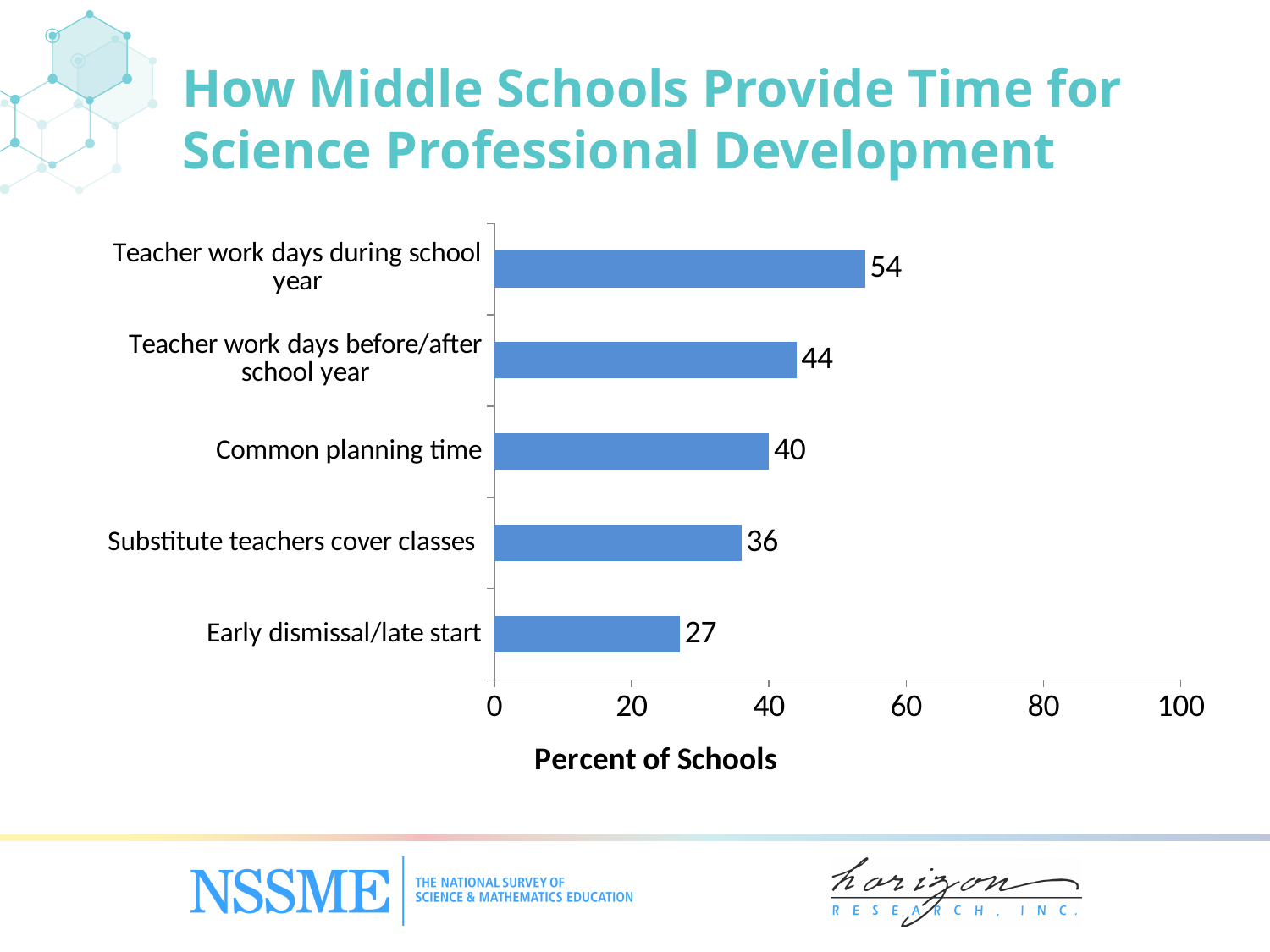
What kind of chart is shown on the slide? Bar chart What is the value for Early dismissal/late start? 27 What is the label of the horizontal axis? Percent of Schools Which is larger: the value for Common planning time or the value for Substitute teachers cover classes? Common planning time What is the difference between the values for Teacher work days during school year and Teacher work days before/after school year? 10 Which category has the highest percent of schools? Teacher work days during school year What is the value for Substitute teachers cover classes? 36 Is the value for Early dismissal/late start greater or less than 40? less What is the value for Common planning time? 40 Which category has the lowest percent of schools? Early dismissal/late start What percent of schools use teacher work days during the school year to provide time for science professional development? 54 How many categories are shown in the chart? 5